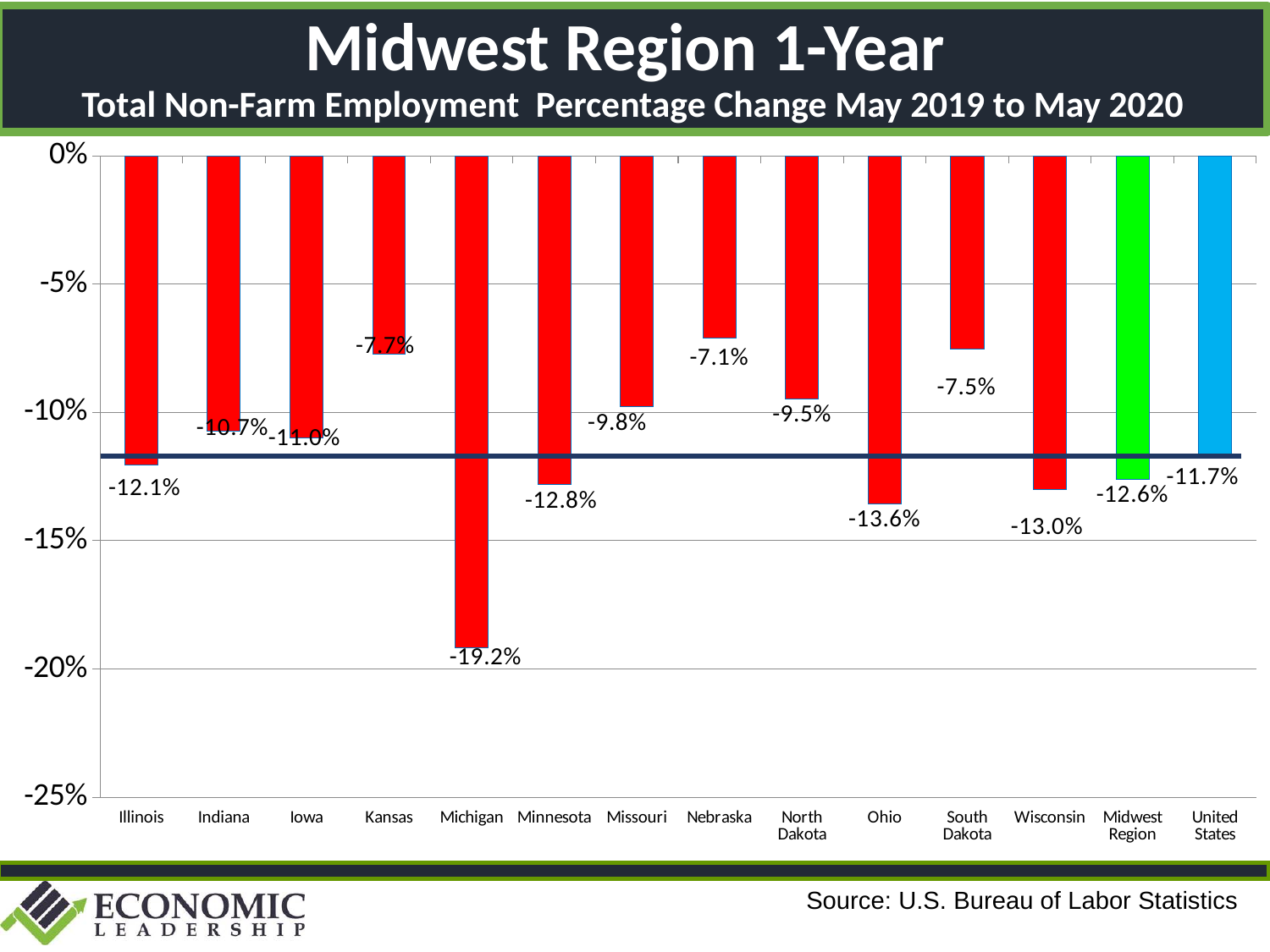
Which category shows the smallest decline (least negative value)? Nebraska Which had a larger decline, Wisconsin or Indiana? Wisconsin What type of chart is shown on the slide? Bar chart What is the percentage change for the Midwest Region? -12.6% What is the percentage change for Ohio? -13.6% What is the percentage change for Nebraska? -7.1% What is the percentage change for the United States? -11.7% By how many percentage points does the Midwest Region's decline exceed the United States' decline? 0.9 percentage points Which category shows the largest decline (most negative value)? Michigan What is the percentage change for Michigan? -19.2% By how many percentage points does Michigan's decline exceed Ohio's decline? 5.6 percentage points How many categories (bars) are shown in the chart? 14